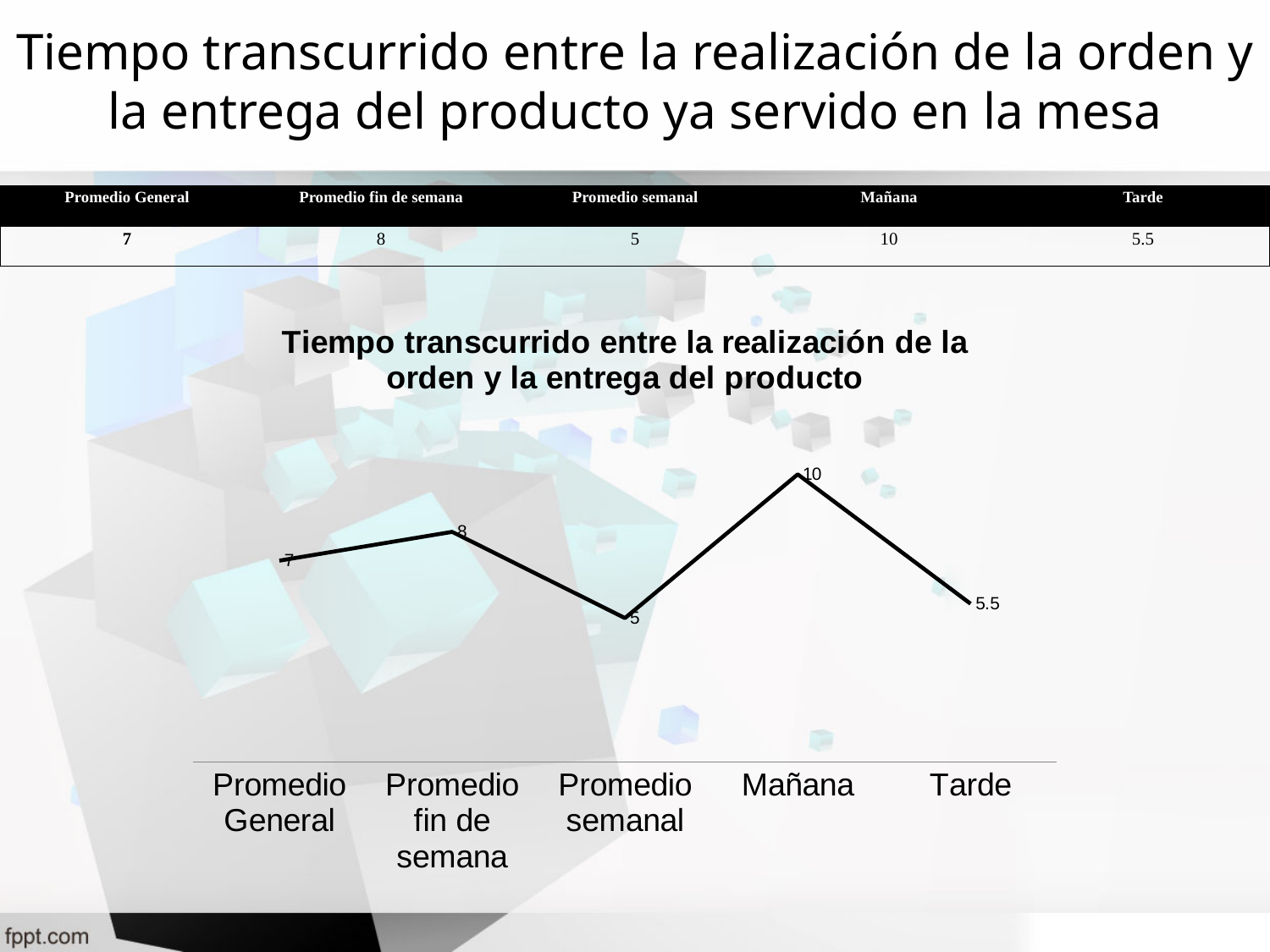
What is the title of the chart? Tiempo transcurrido entre la realización de la orden y la entrega del producto What kind of chart is shown? line chart Which is larger, the value for Promedio General or the value for Tarde? Promedio General How many categories are plotted on the x axis? 5 What is the value for Promedio fin de semana? 8 Which category has the highest value? Mañana What is the value for Mañana? 10 What is the difference between the values for Mañana and Promedio semanal? 5 What is the value for Tarde? 5.5 Does the line rise or fall from Promedio semanal to Mañana? rise What is the value for Promedio General? 7 Which category has the lowest value? Promedio semanal